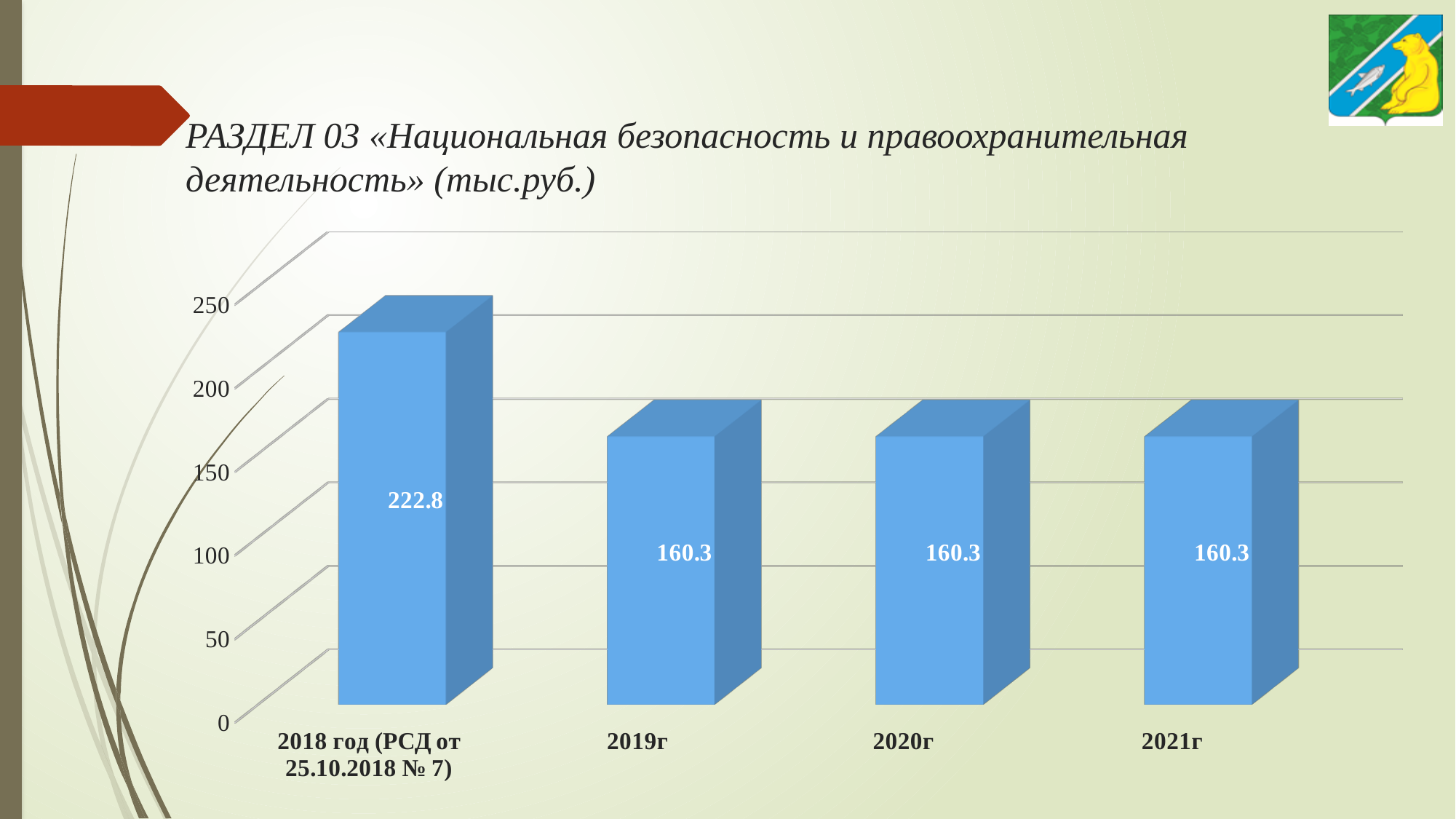
Which category has the highest value? 2018 год (РСД от 25.10.2018 № 7) What is the value for 2021г? 160.3 Is the value for 2020г greater or less than 200? less What unit is given in the chart title? тыс.руб. What is the value for 2018 год (РСД от 25.10.2018 № 7)? 222.8 What is the value for 2019г? 160.3 What is the difference between the values for 2018 год (РСД от 25.10.2018 № 7) and 2020г? 62.5 Which is larger, the value for 2018 год (РСД от 25.10.2018 № 7) or the value for 2019г? 2018 год (РСД от 25.10.2018 № 7) What kind of chart is shown on the slide? bar chart Do the values rise or fall from 2018 to 2019? fall How many categories are shown on the x axis? 4 Is the value for 2018 год (РСД от 25.10.2018 № 7) greater or less than 200? greater